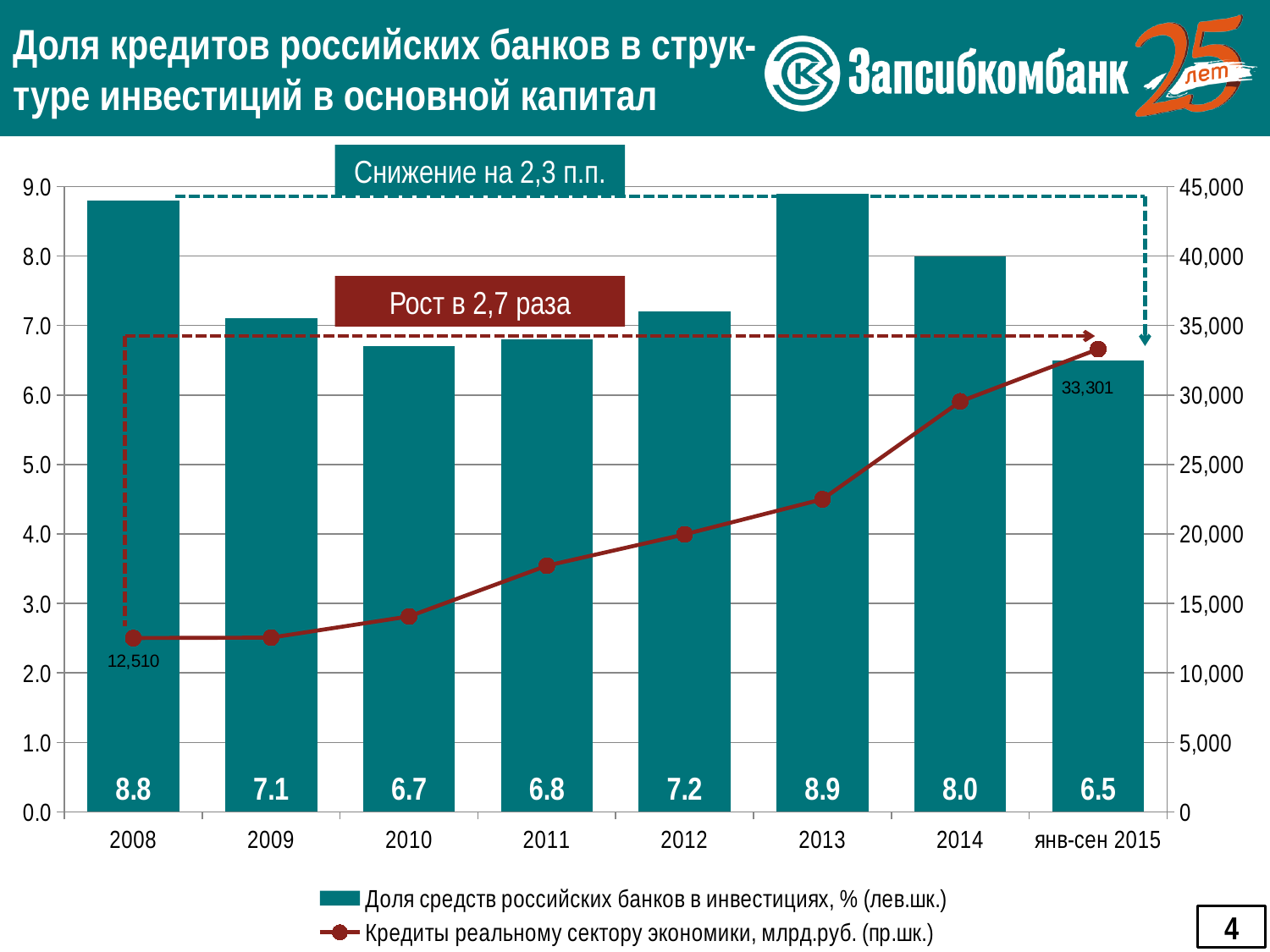
What is the share of Russian banks' funds in investments for 2008? 8.8 Which period has the lowest share of Russian banks' funds in investments? янв-сен 2015 Is the value of loans to the real sector of the economy for 2013 greater or less than 20,000? greater What is the share of Russian banks' funds in investments for 2013? 8.9 What is the difference between the share of Russian banks' funds in investments in 2008 and in янв-сен 2015? 2.3 How many series does the legend list? 2 Which year has the highest share of Russian banks' funds in investments? 2013 Does the line for loans to the real sector of the economy rise or fall from 2008 to янв-сен 2015? rise What is the value of loans to the real sector of the economy (млрд.руб.) for янв-сен 2015? 33,301 Which year has a larger share of Russian banks' funds in investments, 2012 or 2014? 2014 How many periods are shown on the x axis of the chart? 8 What is the value of loans to the real sector of the economy (млрд.руб.) for 2008? 12,510